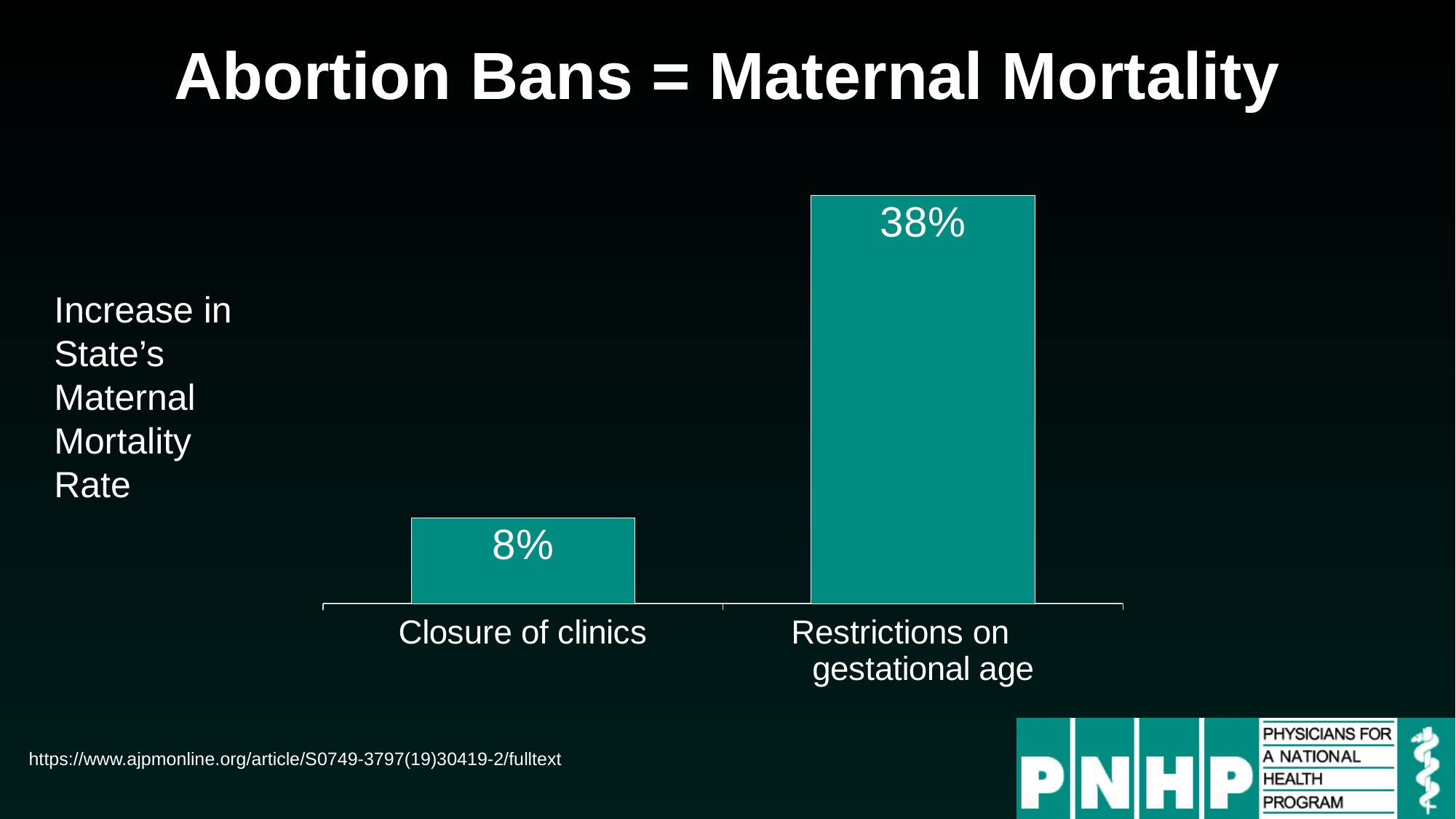
Do the values rise or fall from left to right across the categories? Rise What is the increase in maternal mortality rate for Restrictions on gestational age? 38% Which is larger: the value for Closure of clinics or the value for Restrictions on gestational age? Restrictions on gestational age Which category shows the lowest increase in maternal mortality rate? Closure of clinics Which category shows the highest increase in maternal mortality rate? Restrictions on gestational age How many categories are shown in the chart? 2 What does the text to the left of the chart say the bars measure? Increase in State's Maternal Mortality Rate What is the increase in maternal mortality rate for Closure of clinics? 8% What is the title of the slide containing the chart? Abortion Bans = Maternal Mortality What is the difference between the values for Restrictions on gestational age and Closure of clinics? 30% What kind of chart is shown on the slide? Bar chart